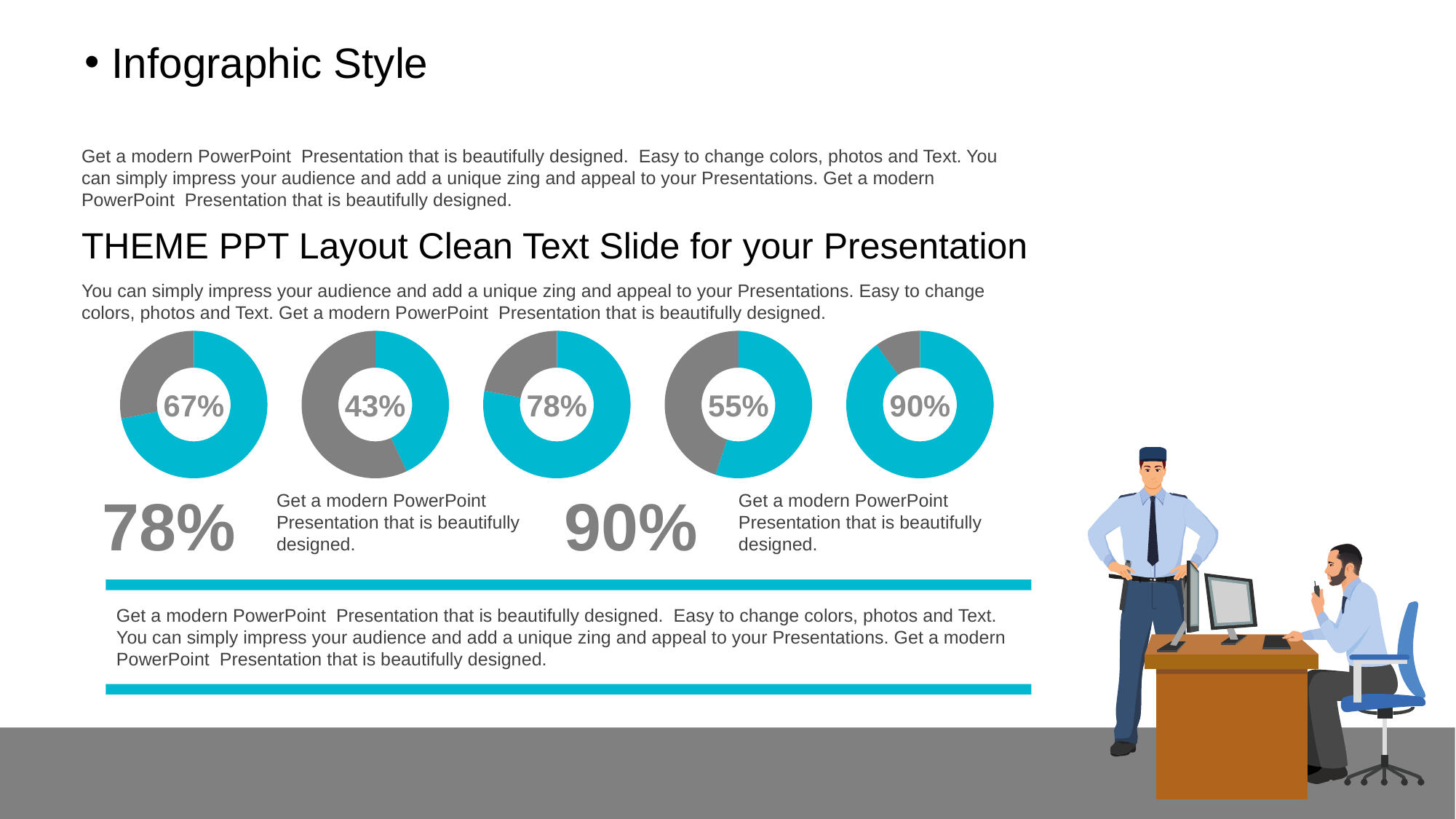
What percentage is shown in the middle (third) donut chart? 78% What percentage is shown in the second donut chart from the left? 43% Which donut chart shows the lowest percentage? The second from the left, 43% What colour is used for the filled (percentage) portion of each donut chart? Teal/cyan blue What percentage is shown in the fifth (rightmost) donut chart? 90% Which donut chart shows the highest percentage? The fifth (rightmost), 90% What kind of chart is used for the five percentage figures in the middle of the slide? Donut chart Which is larger, the percentage in the third donut chart or the fourth donut chart? The third (78%) What percentage is shown in the first (leftmost) donut chart? 67% What is the difference between the percentages in the rightmost and leftmost donut charts? 23% What percentage is shown in the fourth donut chart from the left? 55% How many donut charts are shown on the slide? 5